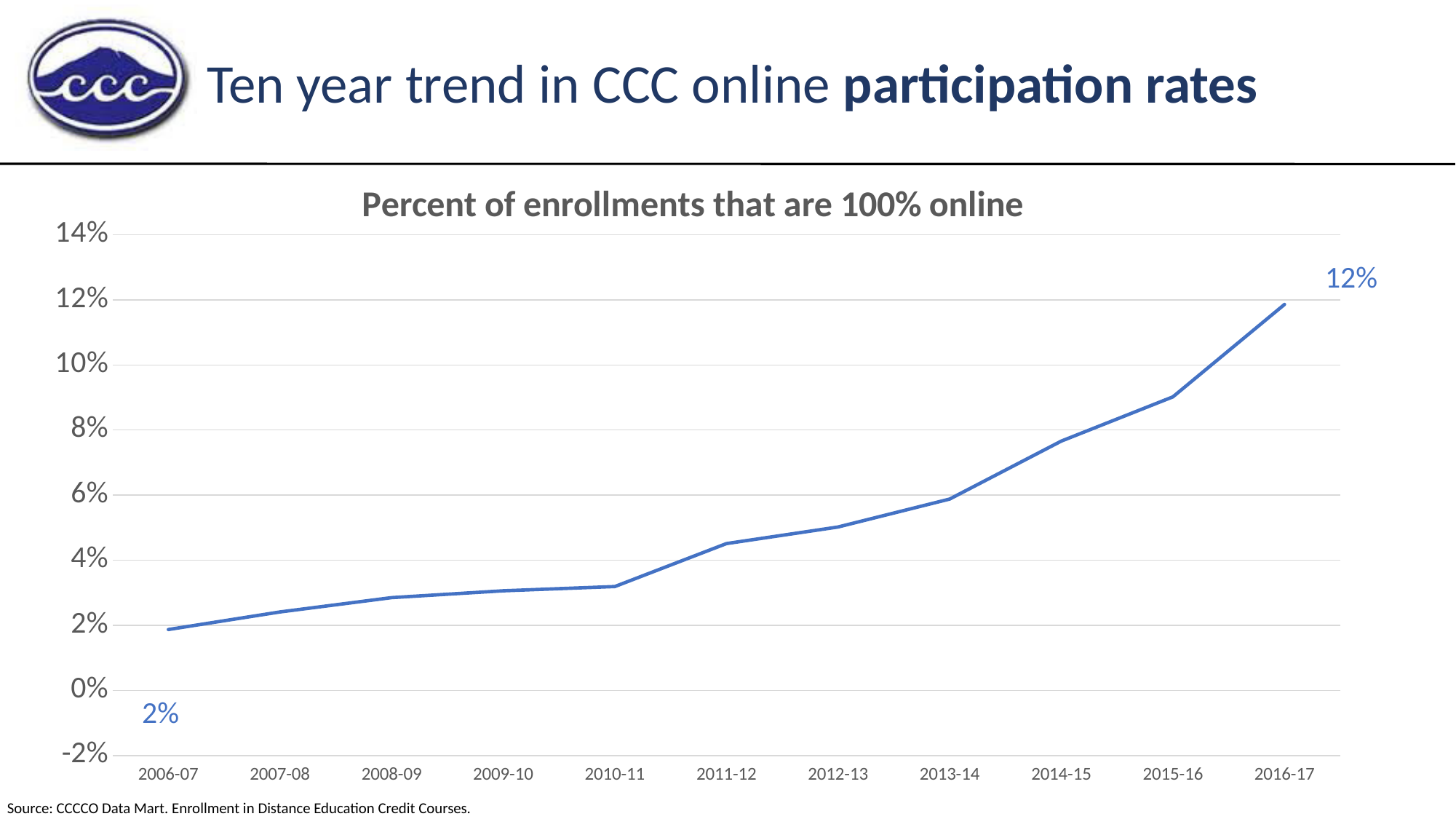
Is the value for 2010-11 greater or less than 4%? less Which year has the lowest percent of enrollments that are 100% online? 2006-07 What is the value for 2006-07? 2% Which year has the highest percent of enrollments that are 100% online? 2016-17 Which is larger, the value for 2013-14 or the value for 2009-10? 2013-14 Is the value for 2011-12 greater or less than 4%? greater What kind of chart is shown on the slide? line chart How many academic years are plotted on the x axis? 11 What is the difference between the values for 2016-17 and 2006-07? 10% What is the value for 2016-17? 12% Is the value for 2015-16 greater or less than 8%? greater Do the values rise or fall from 2006-07 to 2016-17? rise